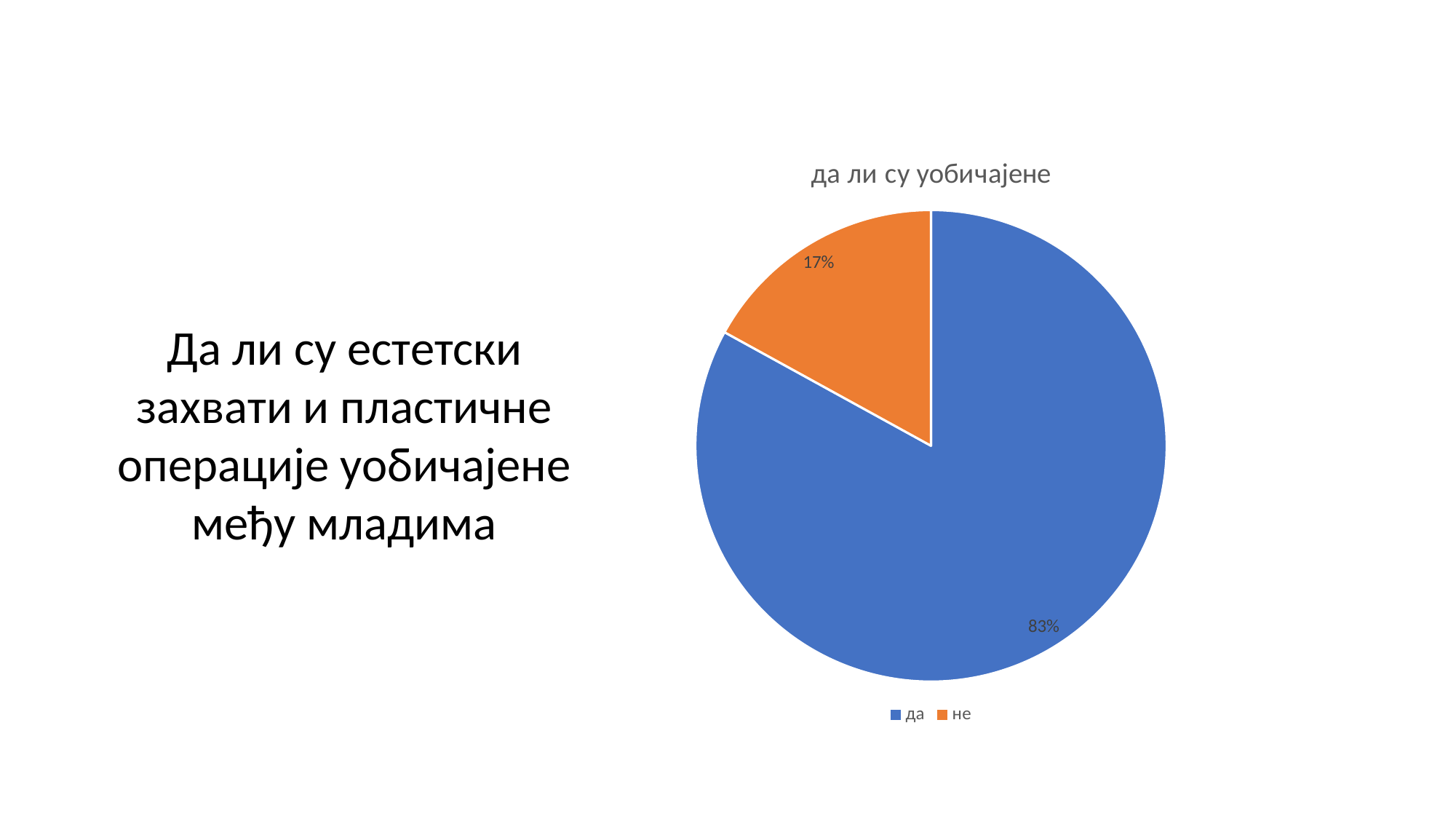
What kind of chart is shown on the slide? pie chart What share of the pie does the "не" slice take? 17% What is the difference in percentage points between the "да" and "не" slices? 66 What is the chart's title? да ли су уобичајене How many slices does the pie chart have? 2 Which slice is the largest? да Which slice is the smallest? не Which is larger, the "да" slice or the "не" slice? да What share of the pie does the "да" slice take? 83% What colour is the "не" slice? orange How many entries does the legend list? 2